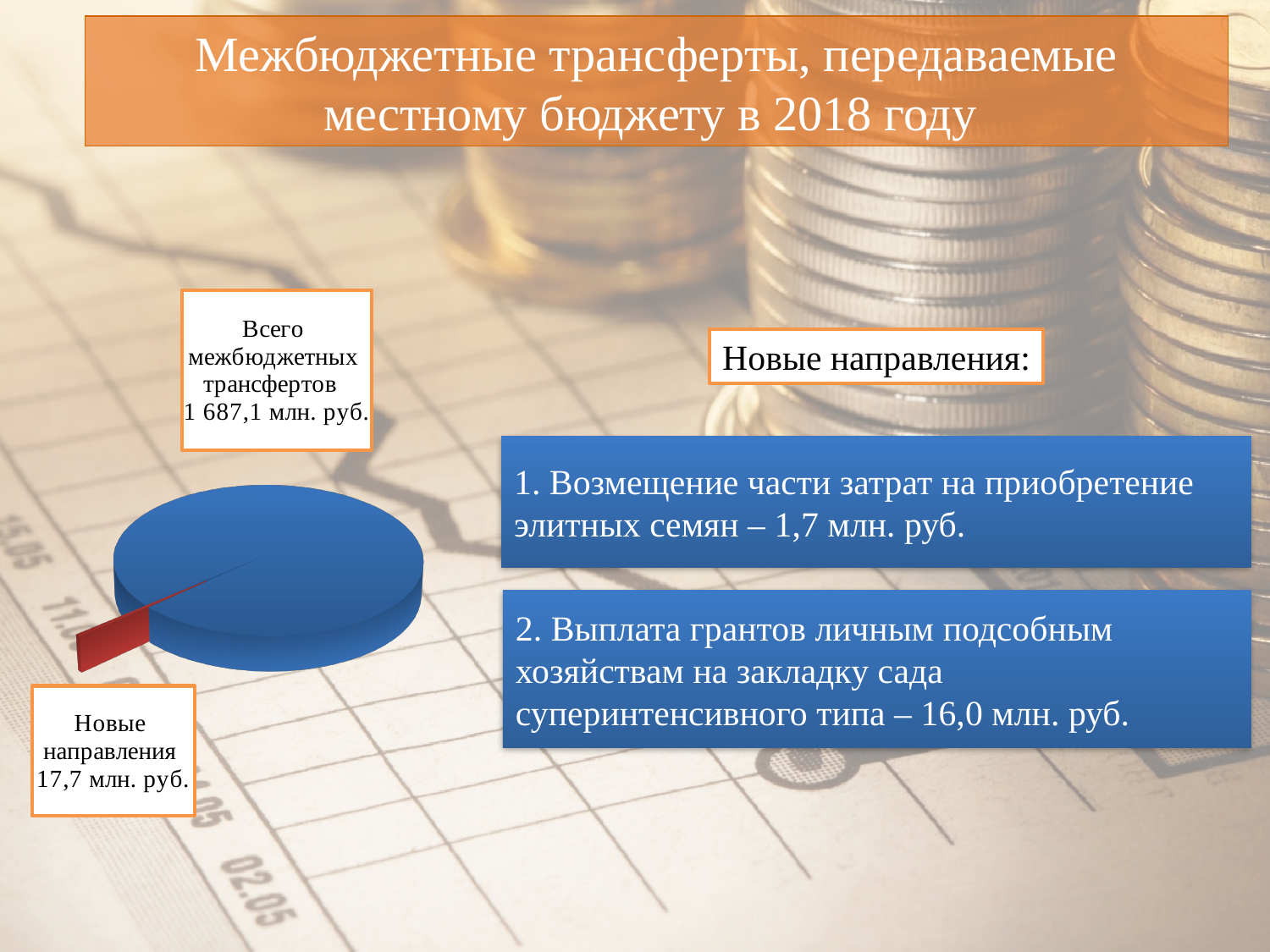
What colour is the slice representing "Новые направления"? Red What kind of chart is shown on the slide? Pie chart Which slice of the pie chart is larger: the blue slice or the red slice? The blue slice Which category does the smallest slice of the pie chart represent? Новые направления What is the total amount of intergovernmental transfers ("Всего межбюджетных трансфертов") shown next to the pie chart? 1 687,1 млн. руб. What year do the intergovernmental transfers on the slide refer to? 2018 Is the total of intergovernmental transfers greater or less than 1 000 млн. руб.? greater What is the value labelled for "Новые направления" next to the pie chart? 17,7 млн. руб. Is the value for "Новые направления" greater or less than 100 млн. руб.? less How many slices does the pie chart have? 2